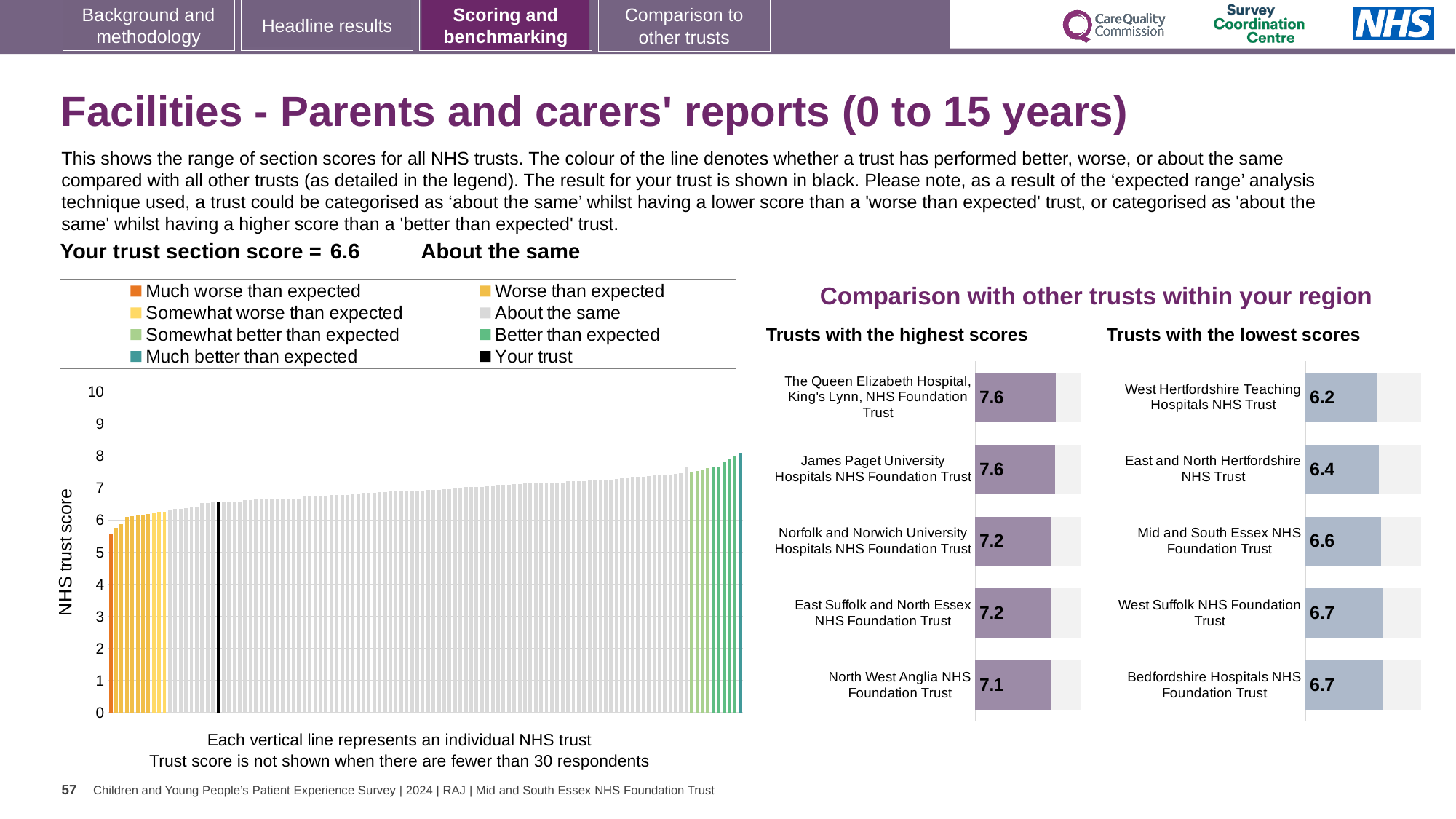
In the 'Trusts with the lowest scores' chart, which trust has the lowest score? West Hertfordshire Teaching Hospitals NHS Trust In the 'Trusts with the highest scores' chart, what is the difference between the score for The Queen Elizabeth Hospital, King's Lynn, NHS Foundation Trust and the score for North West Anglia NHS Foundation Trust? 0.5 In the 'Trusts with the highest scores' chart, what is the score for North West Anglia NHS Foundation Trust? 7.1 How many entries does the legend of the 'NHS trust score' chart on the left list? 8 In the 'NHS trust score' chart on the left, do the trust scores rise or fall from left to right? Rise What kind of chart is the 'NHS trust score' chart on the left? Bar chart How many trusts are shown in the 'Trusts with the lowest scores' chart? 5 In the 'NHS trust score' chart on the left, is the value of the black 'Your trust' bar greater or less than 5? greater In the 'Trusts with the lowest scores' chart, what is the score for East and North Hertfordshire NHS Trust? 6.4 In the 'Trusts with the highest scores' chart, which has the higher score: Norfolk and Norwich University Hospitals NHS Foundation Trust or North West Anglia NHS Foundation Trust? Norfolk and Norwich University Hospitals NHS Foundation Trust In the 'Trusts with the highest scores' chart, which trust has the lowest score? North West Anglia NHS Foundation Trust In the 'Trusts with the lowest scores' chart, what is the difference between the score for Bedfordshire Hospitals NHS Foundation Trust and the score for West Hertfordshire Teaching Hospitals NHS Trust? 0.5